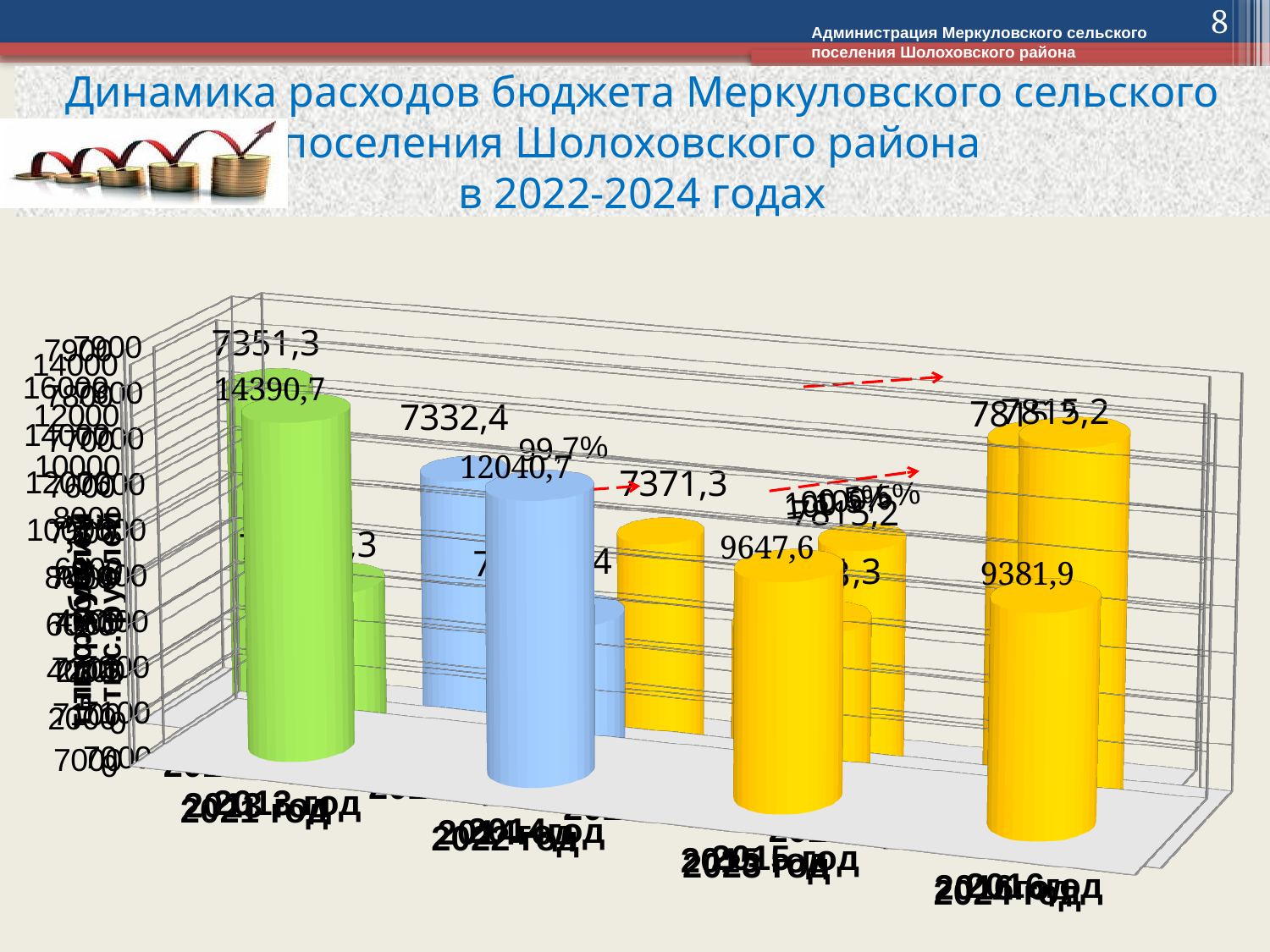
In the front chart, which year has the highest value? 2021 год In the front chart, which is larger: the value for 2021 год or for 2022 год? 2021 год In the front chart, do the values rise or fall from 2021 год to 2024 год? fall In the front chart, what is the value labelled on the yellow bar for 2023 год? 9647,6 In the front chart, which year has the lowest value? 2024 год In the front chart, is the value for 2023 год greater or less than 10000? less In the front chart, what is the difference between the values for 2021 год (14390,7) and 2022 год (12040,7)? 2350,0 What kind of chart is shown on the slide? bar chart In the front chart, what is the value labelled on the blue bar for 2022 год? 12040,7 In the front chart, what is the value labelled on the green bar for 2021 год? 14390,7 In the front chart, what is the value labelled on the yellow bar for 2024 год? 9381,9 What is the title of the chart on the slide? Динамика расходов бюджета Меркуловского сельского поселения Шолоховского района в 2022-2024 годах